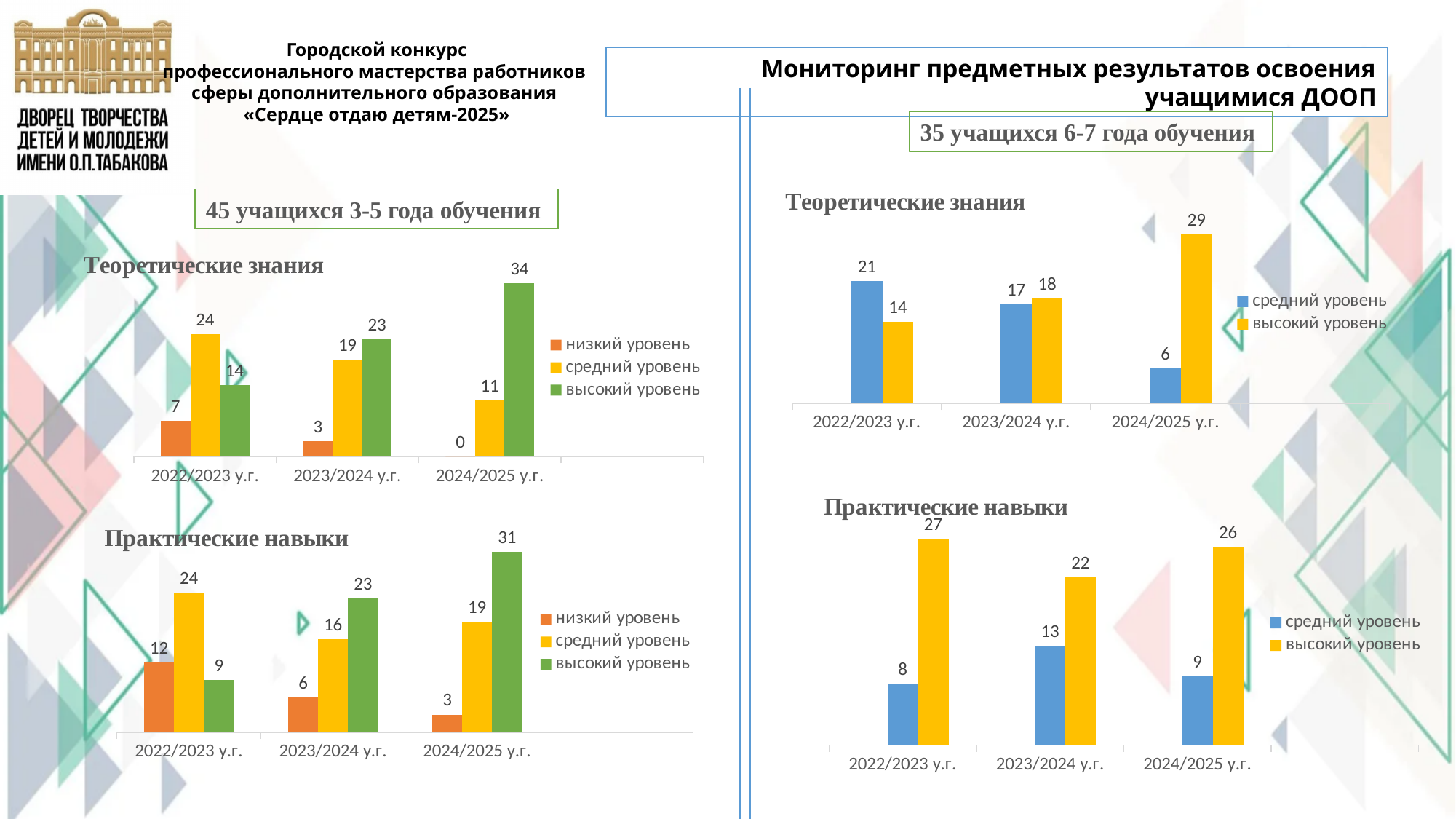
In the top-left chart (Теоретические знания, 45 учащихся), how many series does the legend list? 3 In the bottom-left chart (Практические навыки, 45 учащихся), does the value for низкий уровень rise or fall from 2022/2023 to 2024/2025? fall In the top-right chart (Теоретические знания, 35 учащихся), how many series does the legend list? 2 What kind of chart is the bottom-right chart (Практические навыки, 35 учащихся)? bar chart In the top-left chart (Теоретические знания, 45 учащихся 3-5 года обучения), what is the value for высокий уровень in 2024/2025 у.г.? 34 In the bottom-left chart (Практические навыки, 45 учащихся), which year has the highest value for высокий уровень? 2024/2025 у.г. In the top-right chart (Теоретические знания, 35 учащихся 6-7 года обучения), what is the value for высокий уровень in 2024/2025 у.г.? 29 In the bottom-right chart (Практические навыки, 35 учащихся), what is the value for средний уровень in 2023/2024 у.г.? 13 In the top-left chart (Теоретические знания, 45 учащихся), what is the value for низкий уровень in 2024/2025 у.г.? 0 In the top-left chart (Теоретические знания, 45 учащихся), what is the difference between средний уровень and низкий уровень in 2022/2023 у.г.? 17 In the top-right chart (Теоретические знания, 35 учащихся), which is larger in 2022/2023 у.г.: средний уровень or высокий уровень? средний уровень In the bottom-left chart (Практические навыки, 45 учащихся), what is the value for низкий уровень in 2022/2023 у.г.? 12